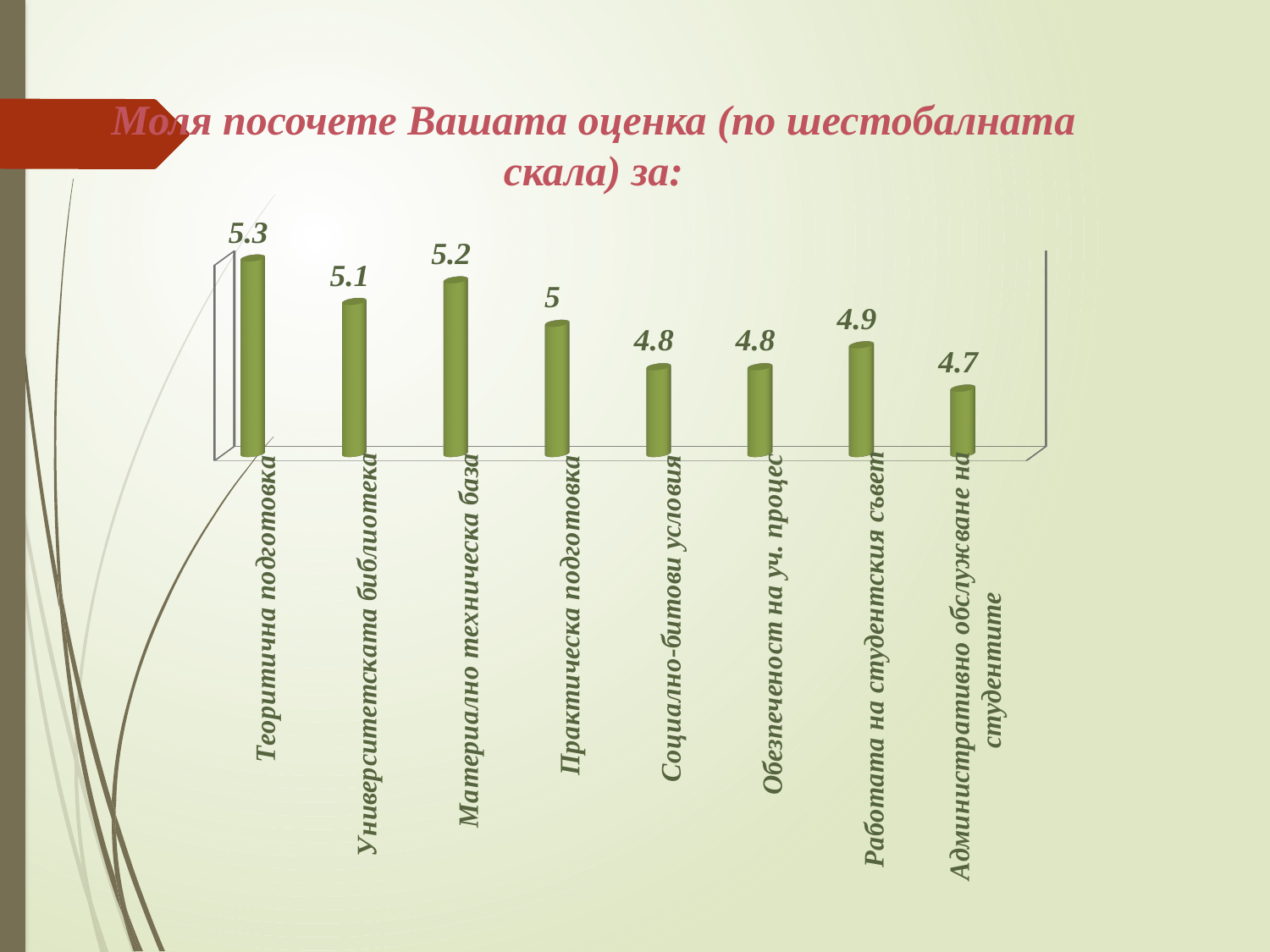
What kind of chart is shown on the slide? Bar chart What is the difference between the values for Теоритична подготовка and Административно обслужване на студентите? 0.6 What is the value for Работата на студентския съвет? 4.9 How many categories are shown in the chart? 8 What is the value for Теоритична подготовка? 5.3 What is the title of the chart on the slide? Моля посочете Вашата оценка (по шестобалната скала) за: Which is larger, the value for Материално техническа база or the value for Практическа подготовка? Материално техническа база What is the value for Материално техническа база? 5.2 Which category has the lowest value? Административно обслужване на студентите What is the value for Административно обслужване на студентите? 4.7 What is the value for Университетската библиотека? 5.1 Which category has the highest value? Теоритична подготовка